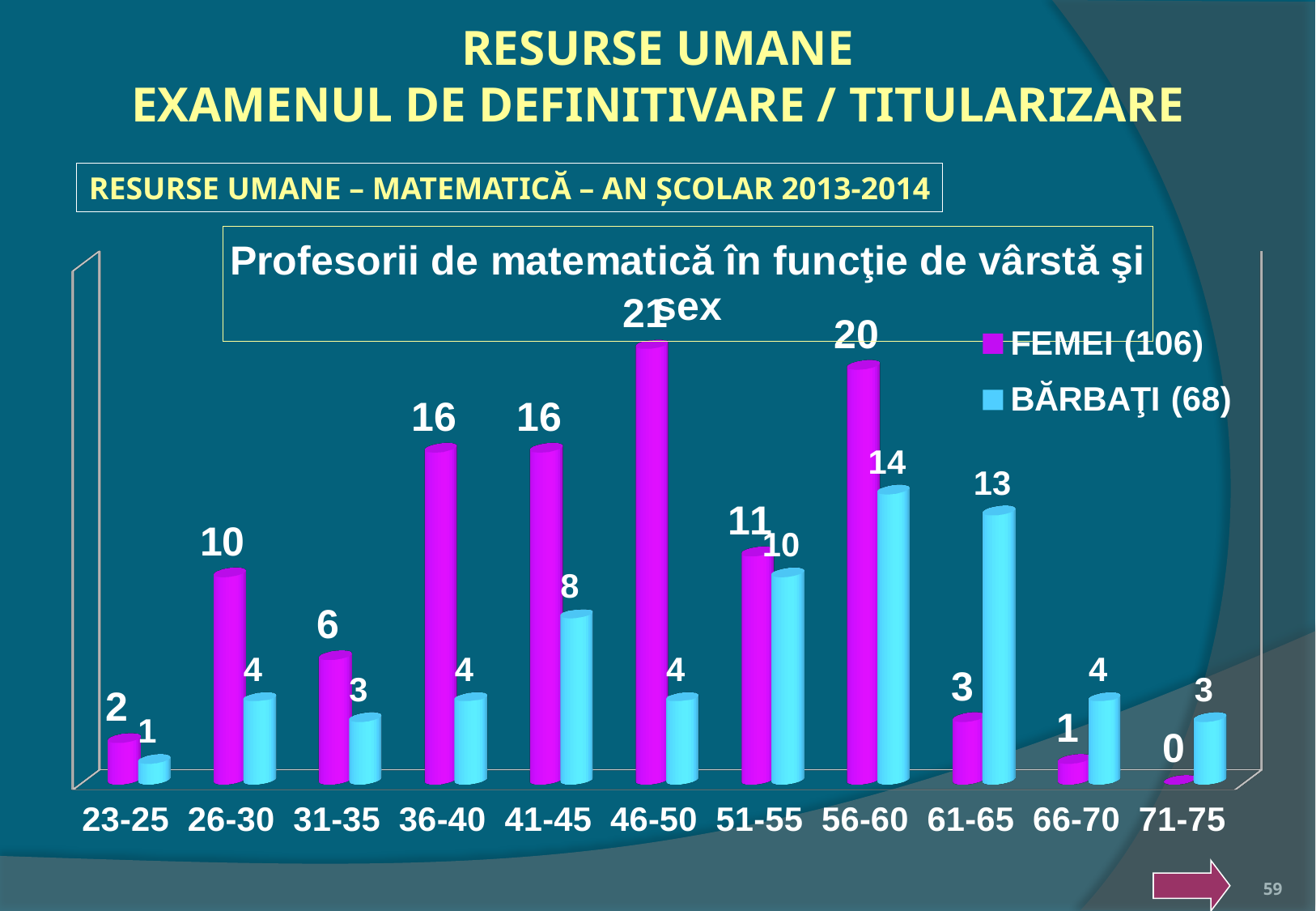
Which age group has the highest value for BĂRBAŢI? 56-60 How many series does the legend list? 2 How many age categories are shown on the x axis? 11 What is the value for BĂRBAŢI in the 61-65 age group? 13 What total is shown in the legend entry for FEMEI? 106 In the 61-65 age group, which series has the larger value, FEMEI or BĂRBAŢI? BĂRBAŢI What is the value for FEMEI in the 71-75 age group? 0 Which age group has the lowest value for BĂRBAŢI? 23-25 What is the value for BĂRBAŢI in the 56-60 age group? 14 What is the value for FEMEI in the 36-40 age group? 16 What is the difference between FEMEI and BĂRBAŢI in the 56-60 age group? 6 What kind of chart is shown on the slide? bar chart